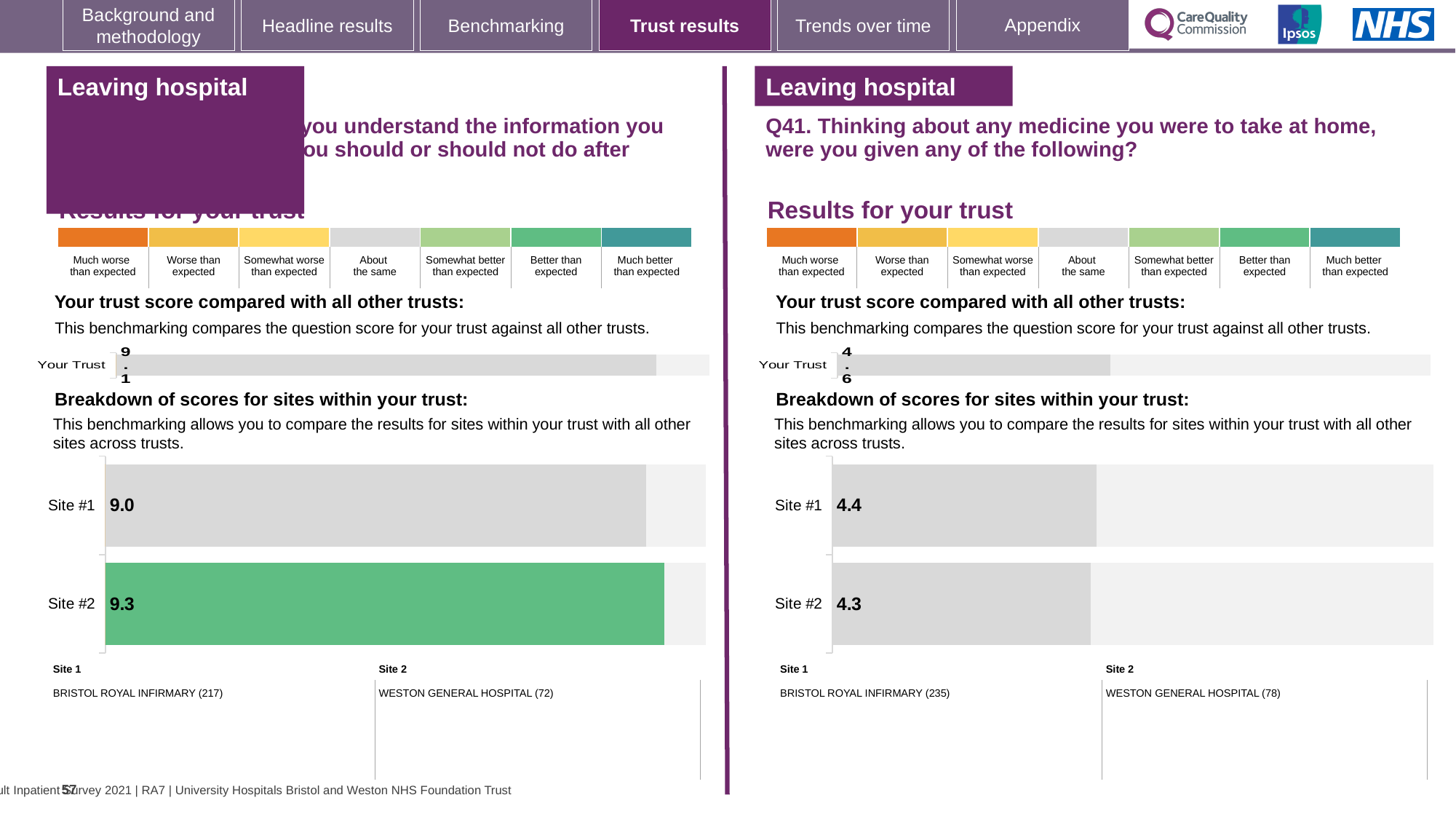
On the left-hand site breakdown chart, which site has the higher score? Site #2 On the left-hand chart (breakdown of scores for sites), what is the score for Site #2? 9.3 On the Q41 chart (breakdown of scores for sites), what is the score for Site #2? 4.3 What type of chart is used for the site breakdown on the left-hand side of the slide? Bar chart On the left-hand site breakdown chart, what is the difference between the Site #2 and Site #1 scores? 0.3 On the Q41 chart (breakdown of scores for sites), what is the score for Site #1? 4.4 On the Q41 site breakdown chart, which site has the lower score? Site #2 How many sites are shown on the Q41 site breakdown chart? 2 On the left-hand 'Your trust score compared with all other trusts' chart, what is the score for Your Trust? 9.1 On the left-hand chart (breakdown of scores for sites), what is the score for Site #1? 9.0 On the Q41 'Your trust score compared with all other trusts' chart, what is the score for Your Trust? 4.6 On the Q41 site breakdown chart, what is the difference between the Site #1 and Site #2 scores? 0.1